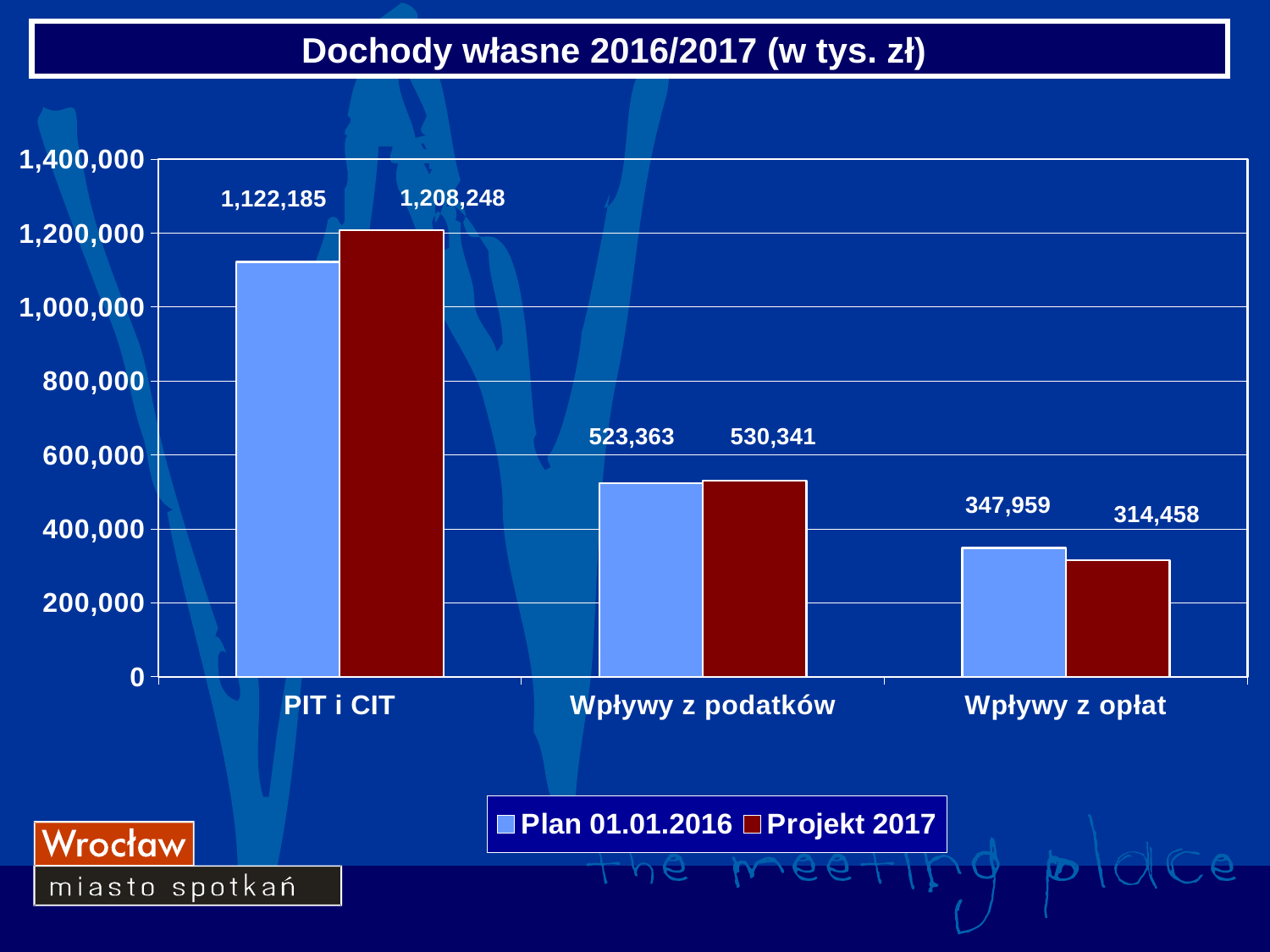
How many categories are shown on the x axis? 3 Which category has the lowest Plan 01.01.2016 value? Wpływy z opłat What is the Projekt 2017 value for Wpływy z podatków? 530,341 What is the Projekt 2017 value for Wpływy z opłat? 314,458 What is the title of the chart? Dochody własne 2016/2017 (w tys. zł) For Wpływy z opłat, which is larger: the Plan 01.01.2016 value or the Projekt 2017 value? Plan 01.01.2016 What is the Plan 01.01.2016 value for PIT i CIT? 1,122,185 What is the difference between the Plan 01.01.2016 and Projekt 2017 values for Wpływy z opłat? 33,501 How many series does the legend list? 2 What is the difference between the Projekt 2017 and Plan 01.01.2016 values for PIT i CIT? 86,063 What kind of chart is shown on the slide? Bar chart Which category has the highest Projekt 2017 value? PIT i CIT